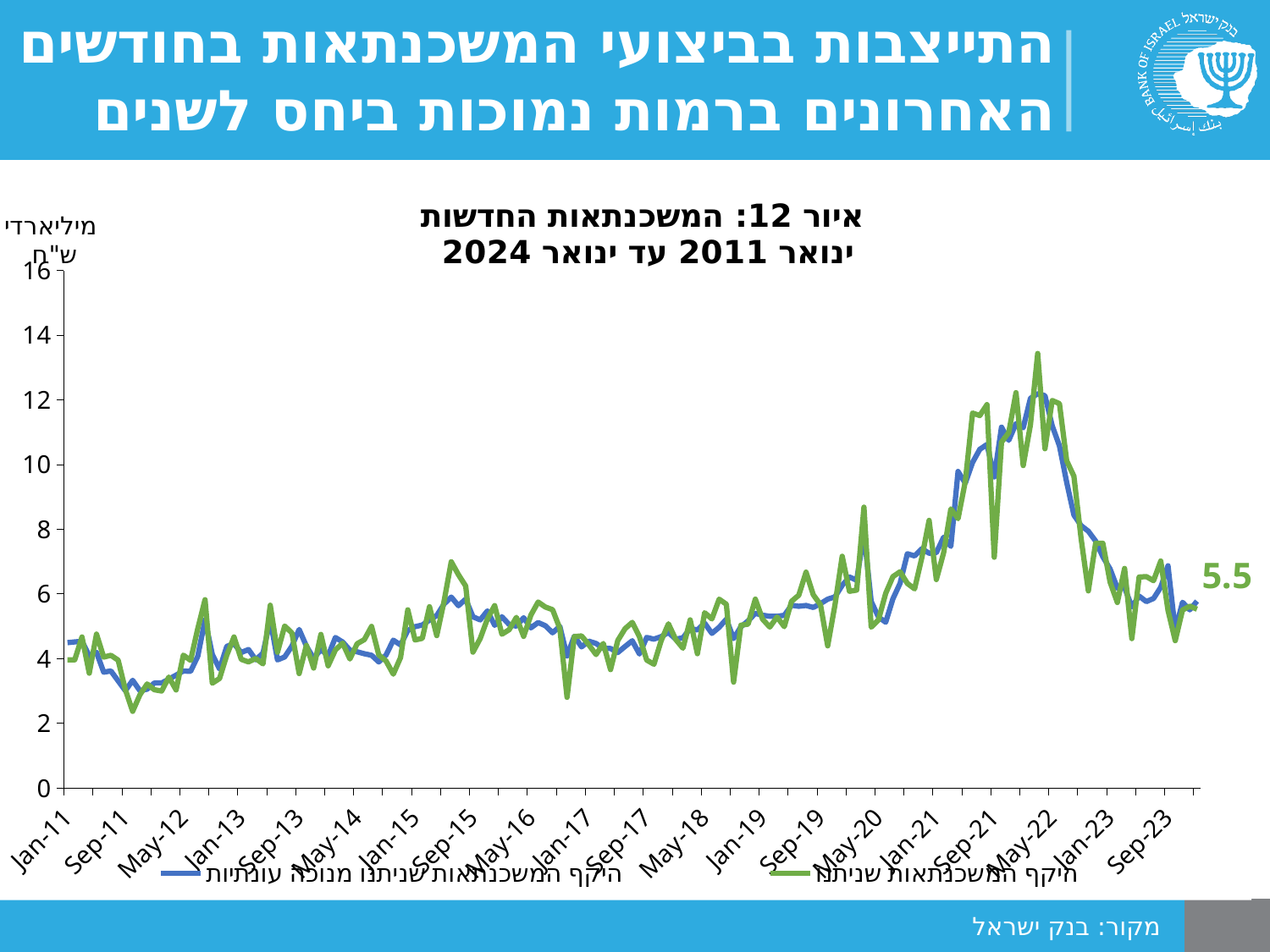
Is the peak value of the green series (היקף המשכנתאות שניתנו) greater or less than 12? greater Do the values generally rise or fall between Jan-19 and May-22? rise How many series does the chart's legend list? 2 What kind of chart is shown on the slide? line chart Is the lowest value of the green series, reached in late 2011, greater or less than 4? less What value is printed as the data label at the right end of the chart? 5.5 Which series reaches the higher peak around May-22, the green one or the blue one? the green one (היקף המשכנתאות שניתנו) Is the value of the blue series at Jan-11 greater or less than 6? less Do the values generally rise or fall between May-22 and Sep-23? fall What is the highest tick value shown on the y axis? 16 What unit is shown on the y axis of the chart? מיליארדי ש"ח What is the title of the chart? איור 12: המשכנתאות החדשות ינואר 2011 עד ינואר 2024